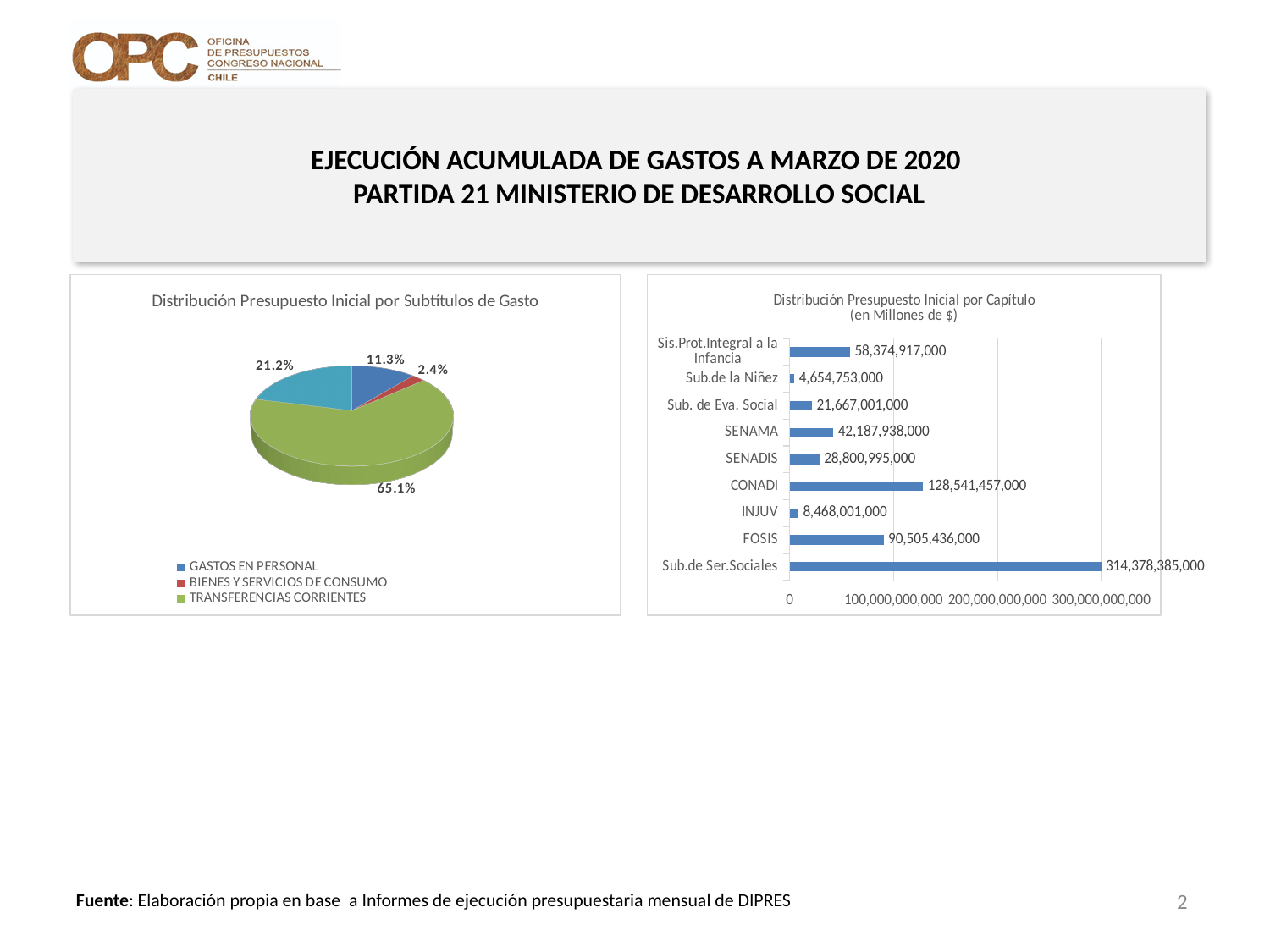
In the pie chart 'Distribución Presupuesto Inicial por Subtítulos de Gasto', what share does BIENES Y SERVICIOS DE CONSUMO have? 2.4% In the chart 'Distribución Presupuesto Inicial por Capítulo', what is the value for SENAMA? 42,187,938,000 In the pie chart 'Distribución Presupuesto Inicial por Subtítulos de Gasto', what share does GASTOS EN PERSONAL have? 11.3% In the chart 'Distribución Presupuesto Inicial por Capítulo', what is the value for CONADI? 128,541,457,000 In the pie chart 'Distribución Presupuesto Inicial por Subtítulos de Gasto', what share does TRANSFERENCIAS CORRIENTES have? 65.1% In the chart 'Distribución Presupuesto Inicial por Capítulo', what is the value for Sub.de la Niñez? 4,654,753,000 In the chart 'Distribución Presupuesto Inicial por Capítulo', which category has the highest value? Sub.de Ser.Sociales In the chart 'Distribución Presupuesto Inicial por Capítulo', which category has the lowest value? Sub.de la Niñez What kind of chart is 'Distribución Presupuesto Inicial por Capítulo'? Bar chart In the chart 'Distribución Presupuesto Inicial por Capítulo', which is larger, SENADIS or Sub. de Eva. Social? SENADIS In the chart 'Distribución Presupuesto Inicial por Capítulo', what is the difference between the values for FOSIS and INJUV? 82,037,435,000 In the chart 'Distribución Presupuesto Inicial por Capítulo', how many categories are shown? 9